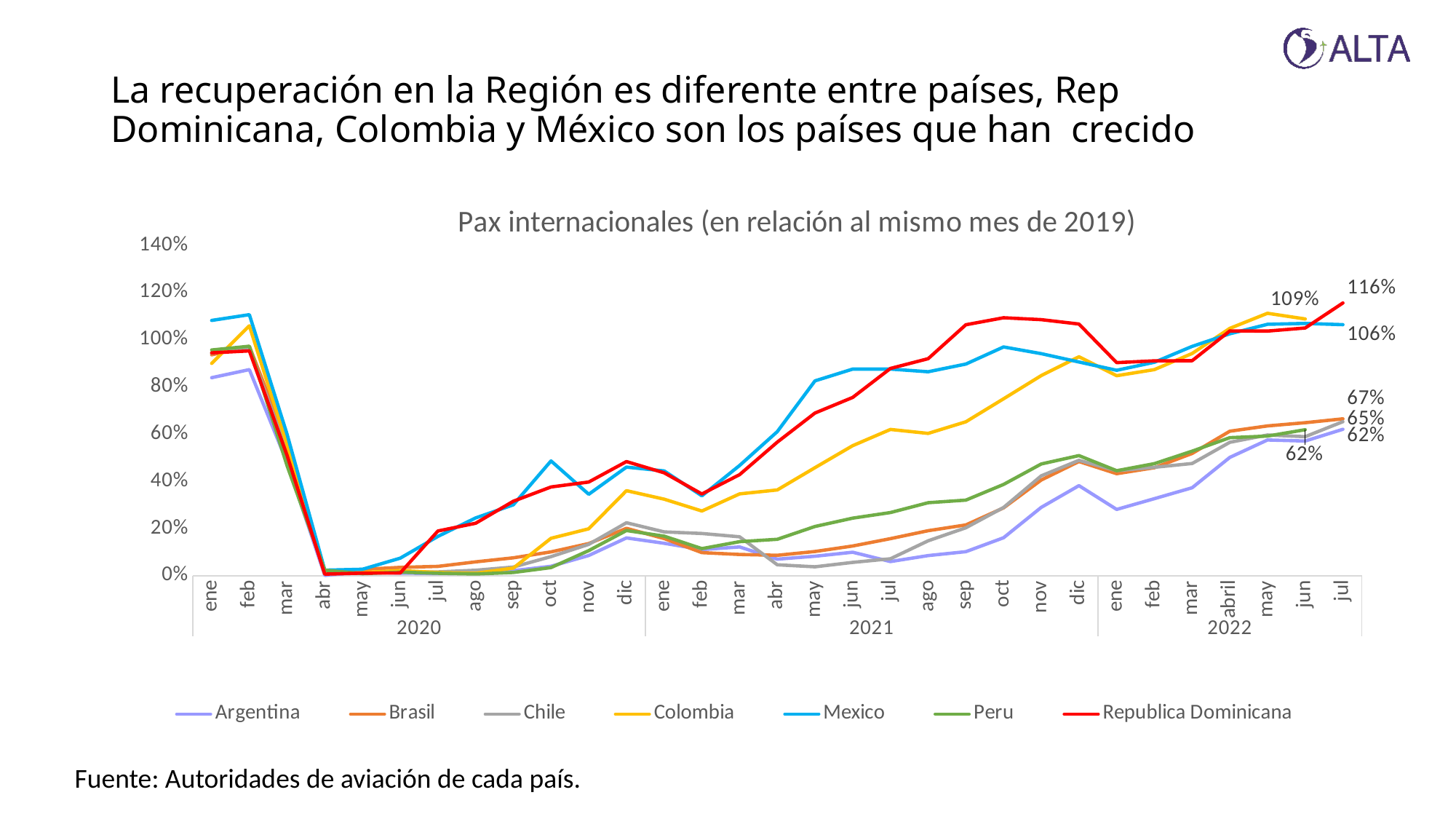
Does the Republica Dominicana line generally rise or fall from abr 2020 to jul 2022? rise In jul 2022, which is larger: the value for Republica Dominicana or the value for Mexico? Republica Dominicana What kind of chart is shown on the slide? line chart What is the value for Republica Dominicana in jul 2022? 116% How many series does the legend list? 7 What is the difference between the Republica Dominicana and Mexico values in jul 2022? 10 percentage points What is the value for Mexico in jul 2022? 106% What is the title of the chart? Pax internacionales (en relación al mismo mes de 2019) Is the value for Argentina in ene 2021 greater or less than 20%? less Which series has the highest value in jul 2022? Republica Dominicana Is the value for Mexico in feb 2020 greater or less than 100%? greater